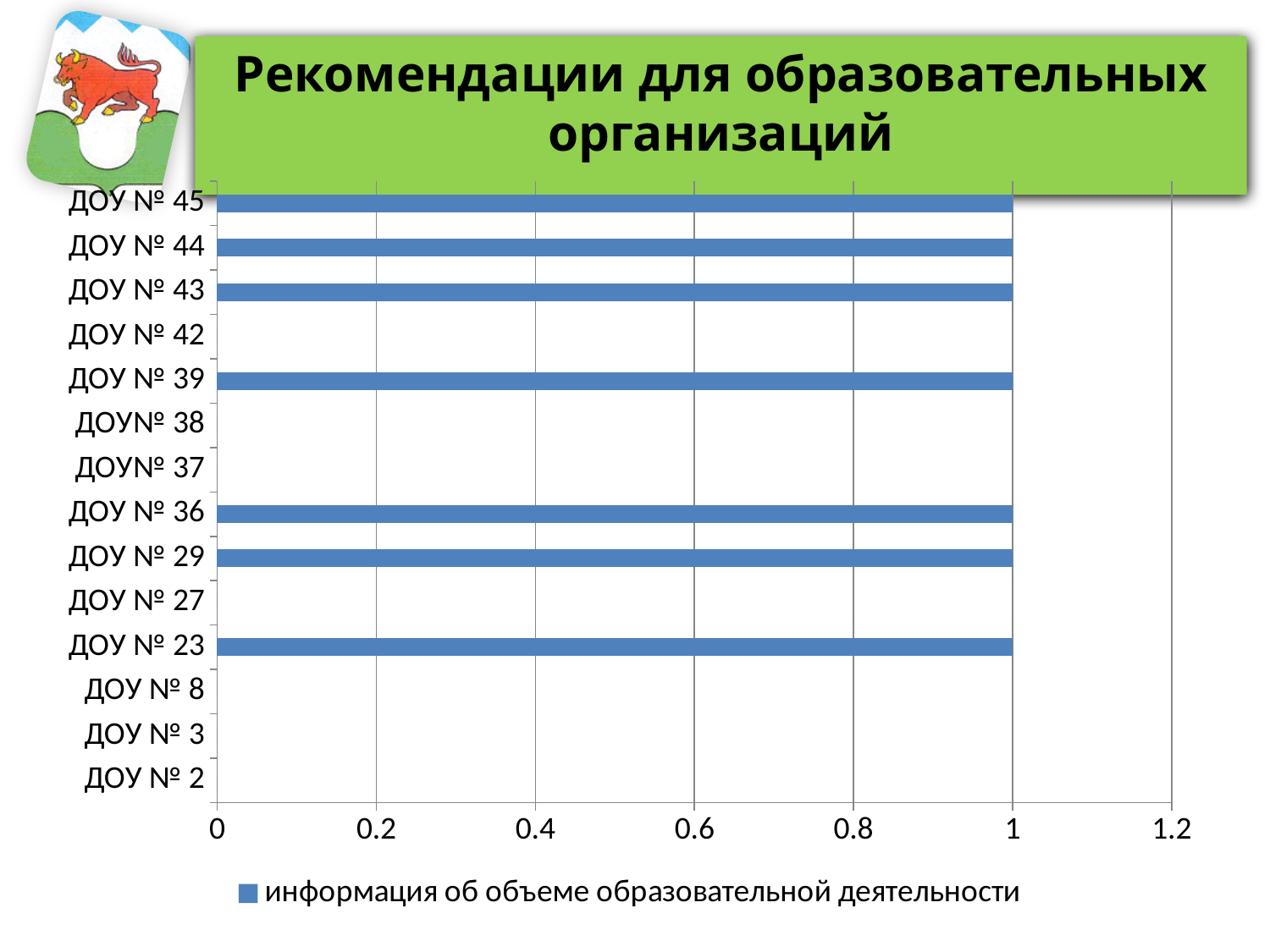
What is the value for ДОУ № 39 in the chart? 1 What is the name of the series shown in the chart legend? информация об объеме образовательной деятельности What is the highest value shown on the horizontal axis of the chart? 1.2 How many categories in the chart have a visible bar? 7 What is the value for ДОУ № 23 in the chart? 1 What is the value for ДОУ № 45 in the chart? 1 What type of chart is shown on the slide? bar chart How many series does the chart legend list? 1 Is the value for ДОУ № 42 greater or less than 0.2? less Is the value for ДОУ № 36 greater or less than 0.8? greater Which is larger, the value for ДОУ № 29 or the value for ДОУ № 27? ДОУ № 29 How many categories (ДОУ) are listed on the vertical axis of the chart? 14